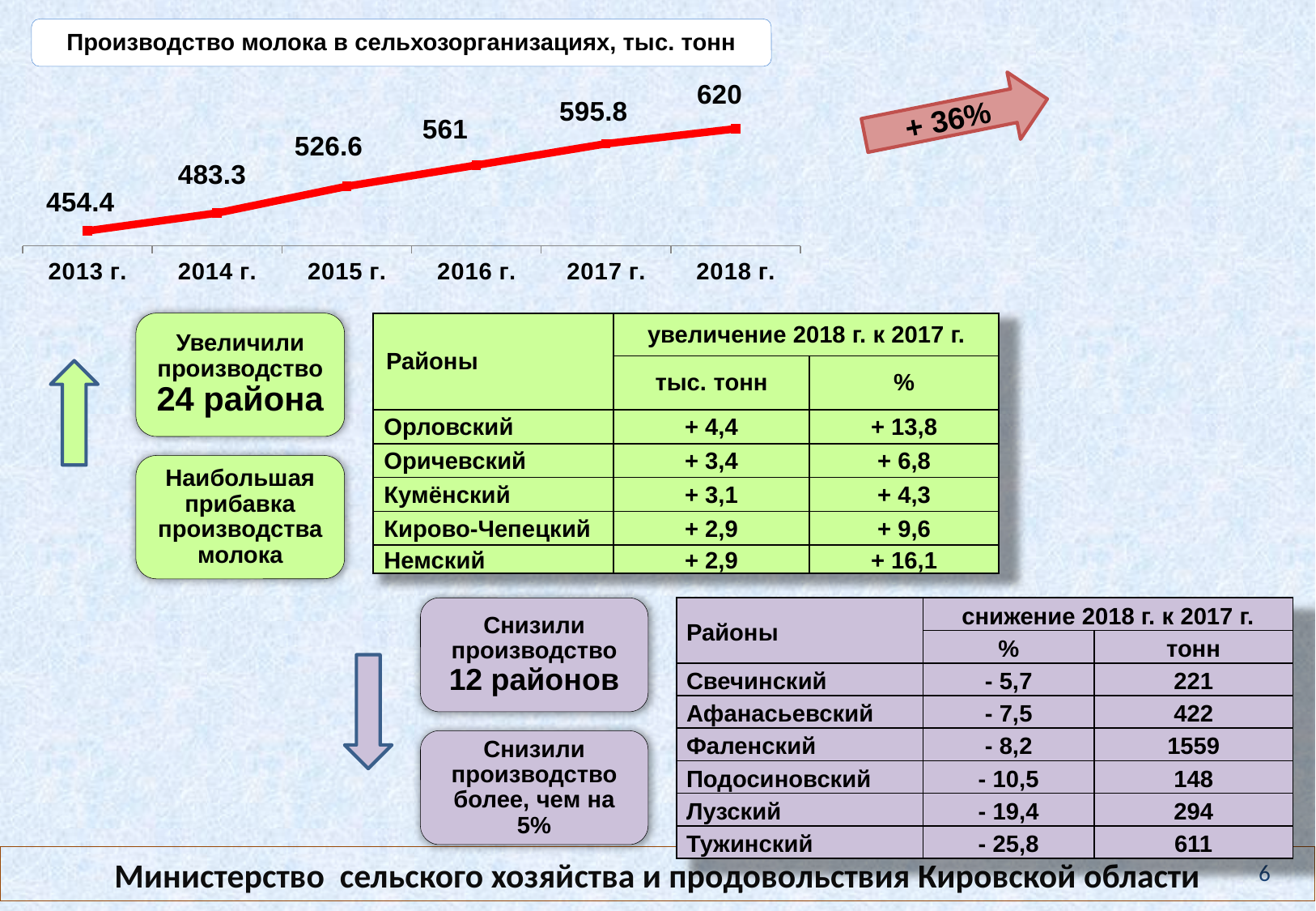
What is the title of the chart? Производство молока в сельхозорганизациях, тыс. тонн Do the values rise or fall from 2013 г. to 2018 г.? rise What type of chart is shown on the slide? line chart What is the difference between the values for 2018 г. and 2013 г.? 165.6 What is the value for 2016 г. in the chart? 561 What is the value for 2013 г. in the chart? 454.4 How many years are plotted on the x axis of the chart? 6 Which is larger, the value for 2015 г. or the value for 2014 г.? 2015 г. What is the value for 2018 г. in the chart? 620 Which year has the lowest value in the chart? 2013 г. Which year has the highest value in the chart? 2018 г. What is the difference between the values for 2017 г. and 2016 г.? 34.8